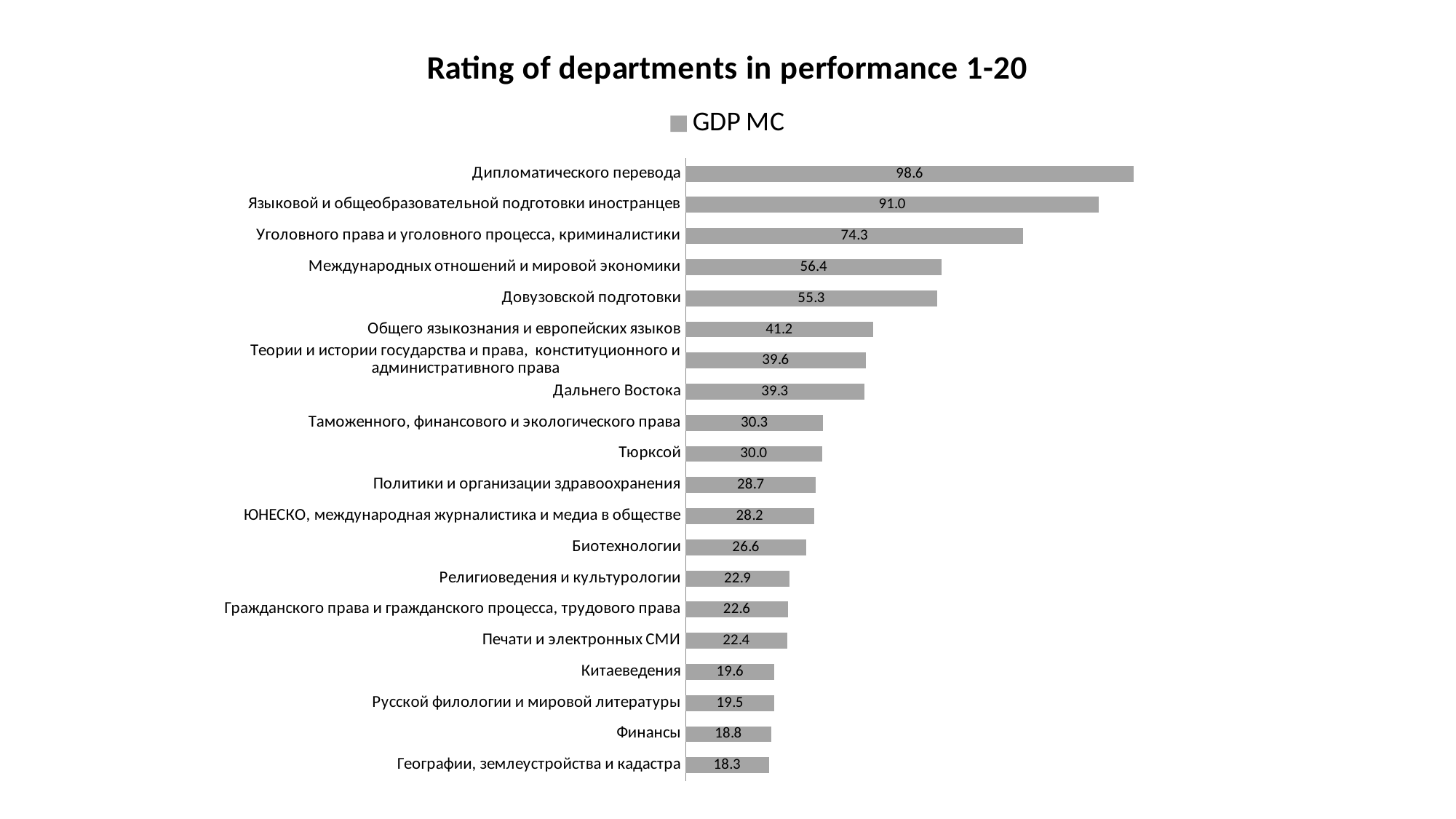
Which is larger, the value for Тюрксой or the value for Китаеведения? Тюрксой What is the difference between the values for Уголовного права и уголовного процесса, криминалистики and Международных отношений и мировой экономики? 17.9 What is the title of the chart? Rating of departments in performance 1-20 How many departments are shown in the chart? 20 What is the value for Довузовской подготовки? 55.3 Which department has the highest value? Дипломатического перевода What kind of chart is shown on the slide? Bar chart How many series does the legend list? 1 What is the value for Дипломатического перевода? 98.6 What is the value for Биотехнологии? 26.6 What is the difference between the values for Дипломатического перевода and Языковой и общеобразовательной подготовки иностранцев? 7.6 Which department has the lowest value? Географии, землеустройства и кадастра